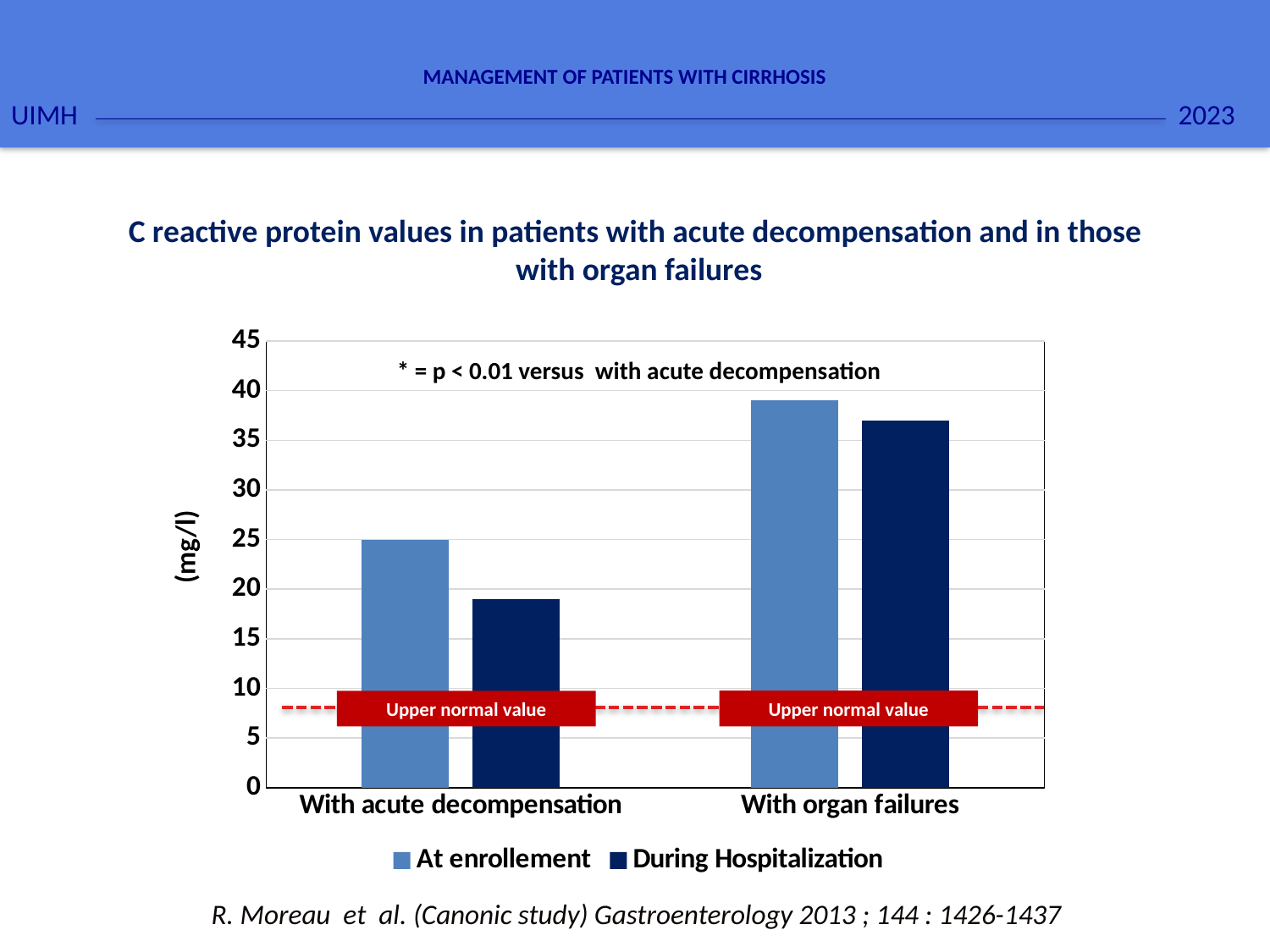
How many categories are shown on the x axis of the chart? 2 Which category has the lowest 'During Hospitalization' value? With acute decompensation Is the 'At enrollement' value for 'With organ failures' greater or less than 35? greater For 'With acute decompensation', which is larger: the 'At enrollement' value or the 'During Hospitalization' value? At enrollement What kind of chart is shown on the slide? bar chart Which is larger: the 'During Hospitalization' value for 'With organ failures' or the 'At enrollement' value for 'With acute decompensation'? During Hospitalization for With organ failures How many series does the chart's legend list? 2 Which category has the highest 'At enrollement' value? With organ failures What label is written on the red dashed line in the chart? Upper normal value Is the 'During Hospitalization' value for 'With acute decompensation' greater or less than 20? less Is the 'During Hospitalization' value for 'With organ failures' greater or less than 30? greater What unit is shown on the y axis of the chart? (mg/l)